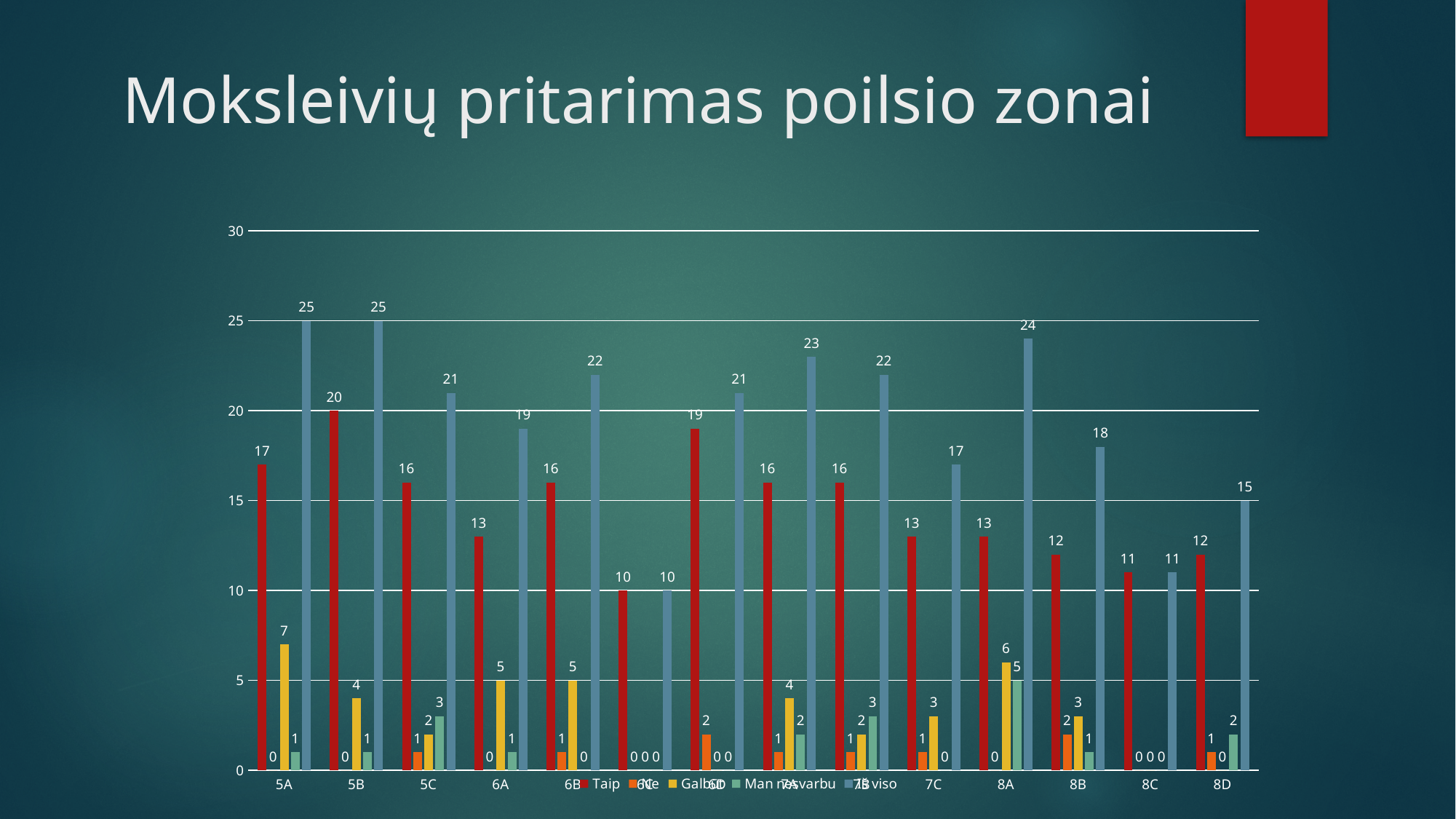
Which is larger, the Taip value for 6D or the Taip value for 7C? 6D What is the Galbūt value for class 5A? 7 How many series does the legend list? 5 Which class has the highest Taip value? 5B How many classes (categories) are shown on the x axis? 14 Which class has the highest Galbūt value? 5A What is the title of the slide? Moksleivių pritarimas poilsio zonai Which class has the lowest Iš viso value? 6C What is the value of the Taip series for class 5B? 20 What is the difference between the Iš viso values for 5A and 8D? 10 What is the Iš viso value for class 8A? 24 What kind of chart is shown on the slide? Bar chart